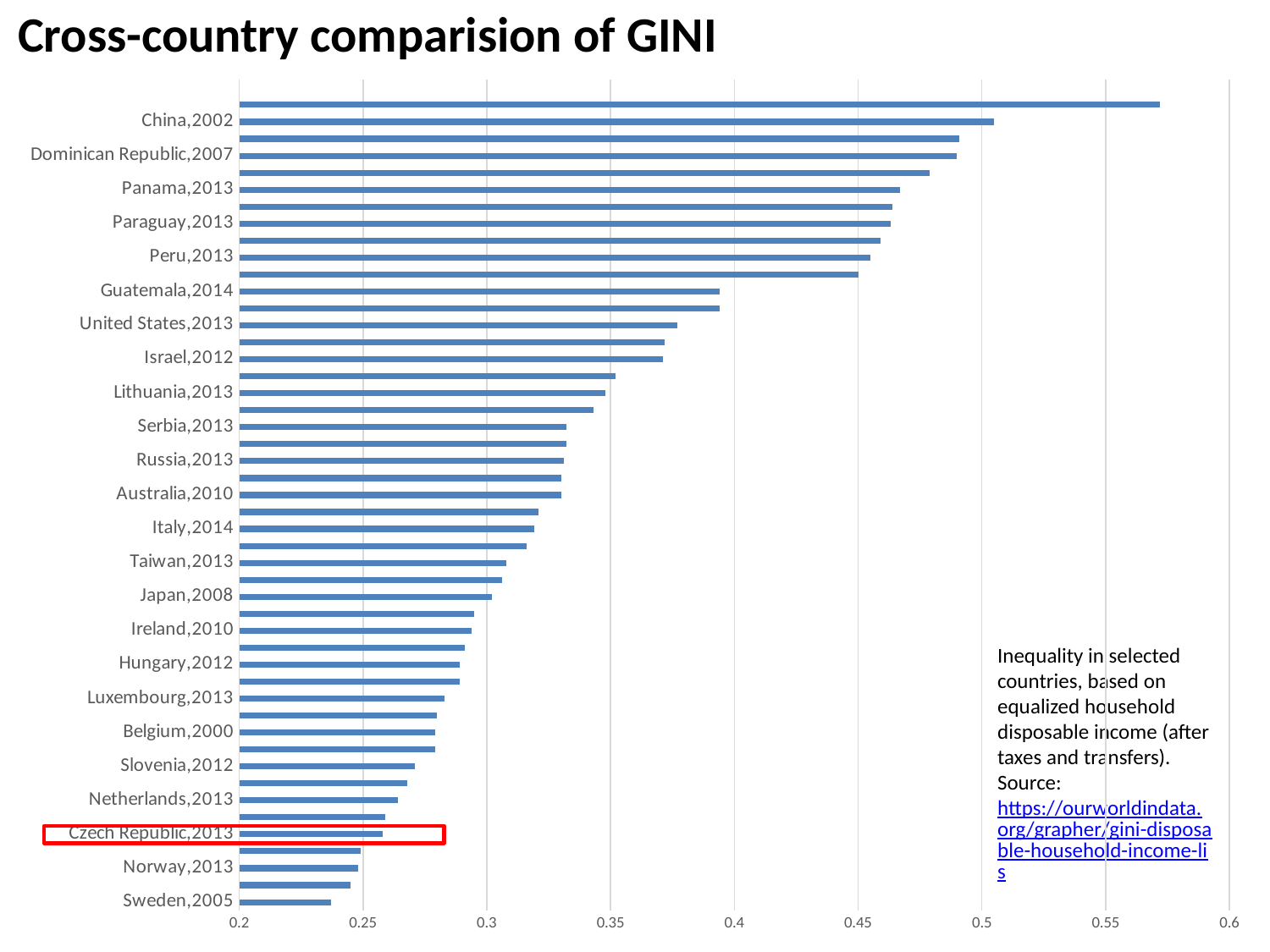
Which category is highlighted with a red box on the chart? Czech Republic,2013 Is the value for China,2002 greater or less than 0.45? greater Do the bar values increase or decrease going from the top of the chart to the bottom? decrease Which has the larger value, China,2002 or Sweden,2005? China,2002 Is the value for United States,2013 greater or less than 0.35? greater Is the value for Peru,2013 greater or less than 0.4? greater Which labelled category has the lowest value? Sweden,2005 Which has the larger value, Guatemala,2014 or Israel,2012? Guatemala,2014 What kind of chart is shown on the slide? bar chart